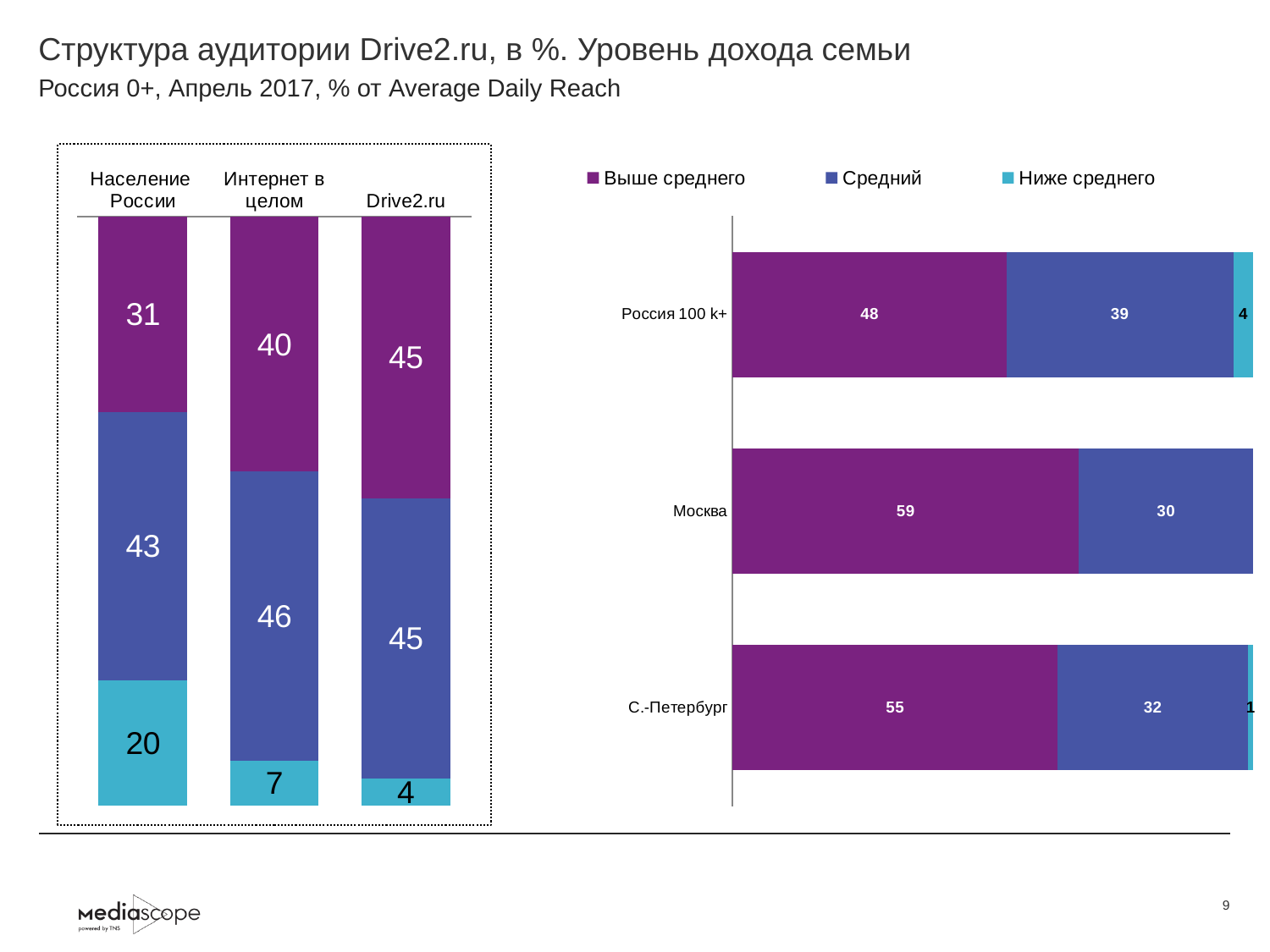
In the right chart, is the 'Средний' value larger for 'Россия 100 k+' or for 'Москва'? Россия 100 k+ In the left chart, what is the value of the 'Ниже среднего' segment for 'Население России'? 20 In the left chart, what is the value of the 'Средний' segment for 'Интернет в целом'? 46 In the right chart, what is the 'Средний' value for 'С.-Петербург'? 32 In the right chart, what is the total of the stacked bar for 'Россия 100 k+'? 91 In the left chart, what is the difference between the 'Выше среднего' values for 'Drive2.ru' and 'Население России'? 14 How many series does the legend of the right chart list? 3 In the right chart, which category has the highest 'Выше среднего' value? Москва In the left chart, which category has the lowest 'Ниже среднего' value? Drive2.ru In the right chart, what is the 'Выше среднего' value for 'Москва'? 59 In the left chart, how many categories are shown? 3 In the left chart, what is the value of the 'Выше среднего' segment for 'Drive2.ru'? 45